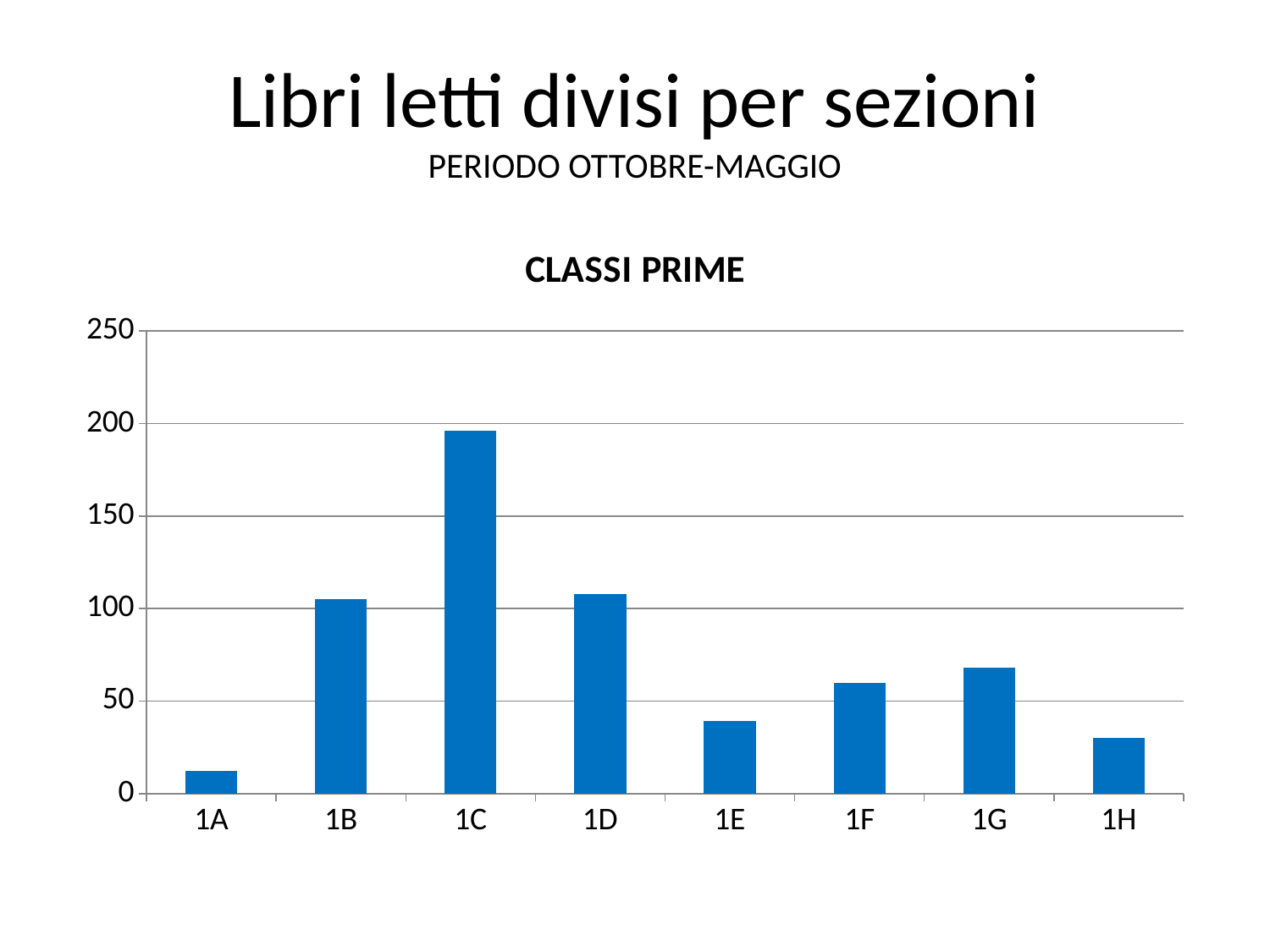
Which class has a larger value, 1C or 1D? 1C What is the title of the chart? CLASSI PRIME Is the value for 1E greater or less than 50? less Is the value for 1C greater or less than 150? greater Which class has the lowest number of books read? 1A Is the value for 1B greater or less than 50? greater What type of chart is shown on the slide? bar chart How many classes (categories) are shown on the x axis of the chart? 8 Which class has the highest number of books read? 1C Which class has a larger value, 1H or 1F? 1F